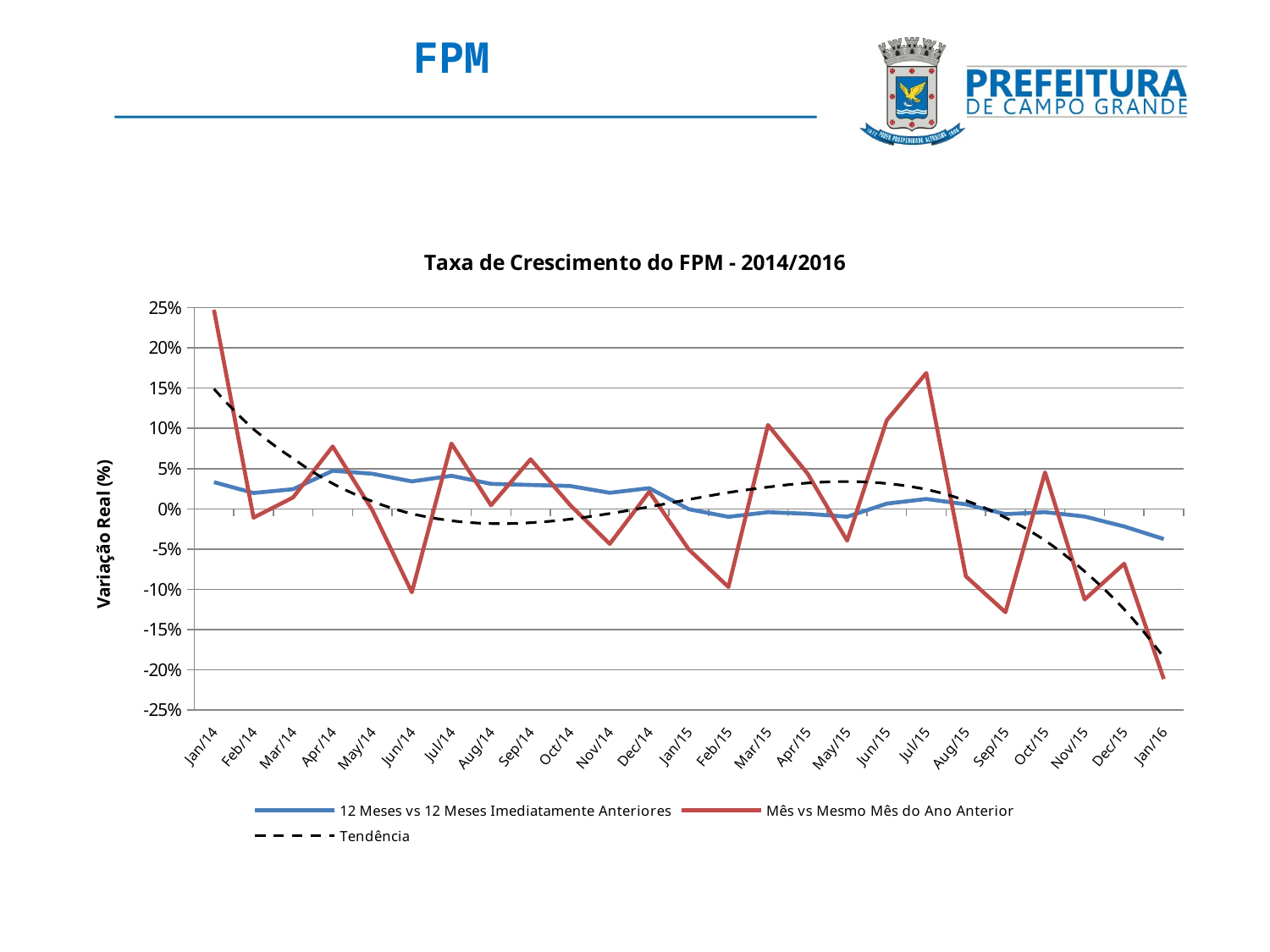
How many months are plotted along the x axis? 25 What kind of chart is shown on the slide? line chart Which is larger for the 'Mês vs Mesmo Mês do Ano Anterior' series: the value for Feb/15 or the value for Jan/16? Feb/15 In which month does the 'Mês vs Mesmo Mês do Ano Anterior' series reach its lowest value? Jan/16 Is the value of 'Mês vs Mesmo Mês do Ano Anterior' for Jan/14 greater or less than 20%? greater What is the title of the chart? Taxa de Crescimento do FPM - 2014/2016 Is the value of 'Mês vs Mesmo Mês do Ano Anterior' for Jun/14 greater or less than -5%? less In which month does the '12 Meses vs 12 Meses Imediatamente Anteriores' series reach its lowest value? Jan/16 In which month does the 'Mês vs Mesmo Mês do Ano Anterior' series reach its highest value? Jan/14 Is the value of 'Mês vs Mesmo Mês do Ano Anterior' for Jul/15 greater or less than 15%? greater Does the '12 Meses vs 12 Meses Imediatamente Anteriores' series overall rise or fall from Jan/14 to Jan/16? fall How many series does the legend list? 3